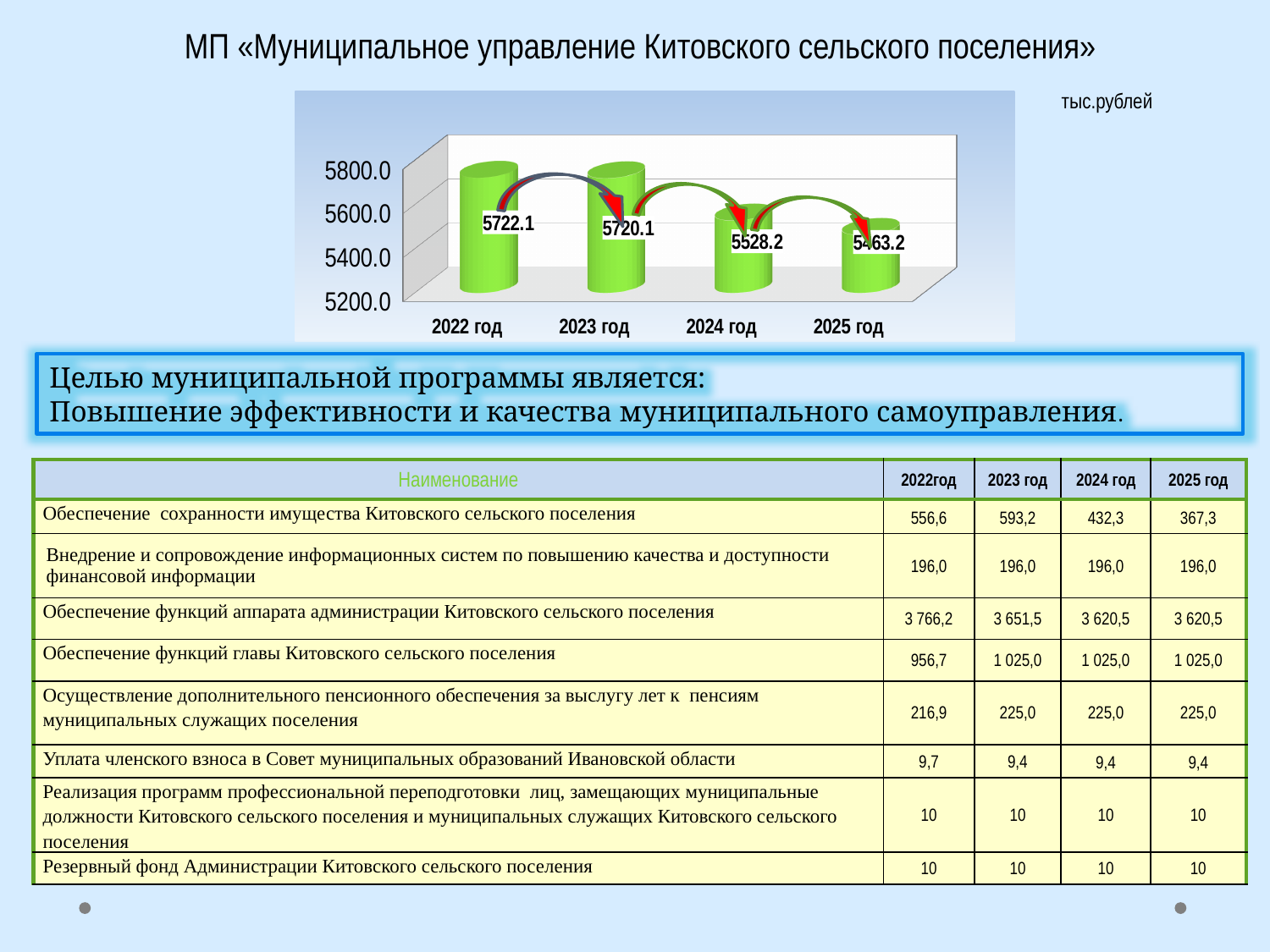
Do the values rise or fall from 2022 год to 2025 год? fall Which year has the lowest value in the chart? 2025 год Is the value for 2025 год greater or less than 5600.0? less What is the value shown for 2024 год in the chart? 5528.2 Which is larger, the value for 2023 год or the value for 2024 год? 2023 год What is the difference between the values for 2022 год and 2023 год? 2.0 How many years are plotted in the chart? 4 What is the value shown for 2022 год in the chart? 5722.1 What kind of chart is shown on the slide? bar chart What is the difference between the values for 2023 год and 2024 год? 191.9 Is the value for 2022 год greater or less than 5600.0? greater What is the value shown for 2023 год in the chart? 5720.1